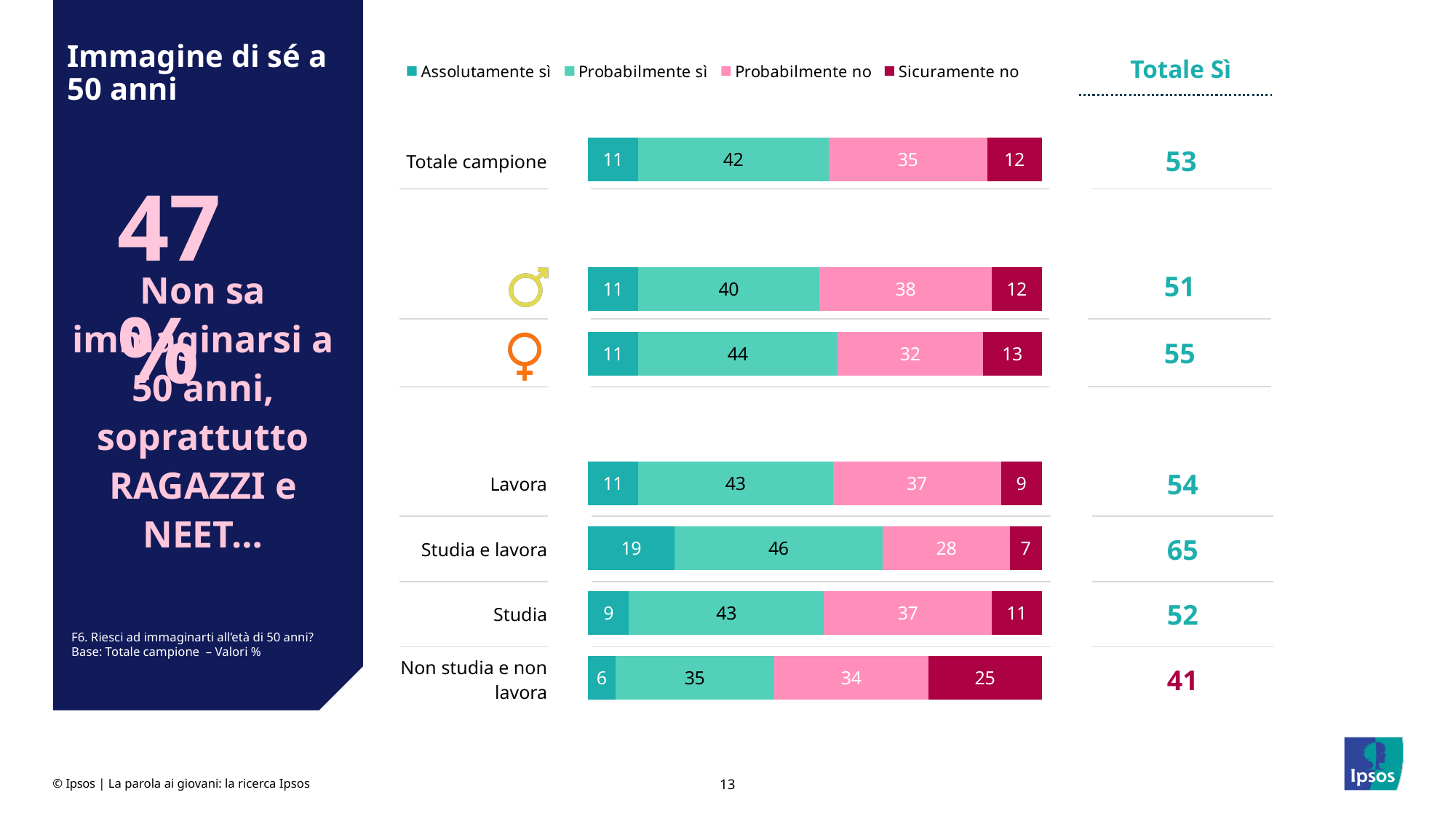
What is the "Totale Sì" value shown for "Studia e lavora"? 65 What kind of chart is shown on the slide? Stacked bar chart Which is larger: the "Probabilmente no" value for "Lavora" or for "Studia e lavora"? Lavora What is the value of "Probabilmente sì" for "Totale campione"? 42 How many series does the legend list? 4 What is the value of "Sicuramente no" for "Non studia e non lavora"? 25 Which category has the highest "Sicuramente no" value? Non studia e non lavora What is the value of "Probabilmente no" for "Studia"? 37 What is the difference between the "Probabilmente sì" values for "Studia e lavora" and "Non studia e non lavora"? 11 How many categories (bars) are shown in the chart? 7 Which category has the lowest "Assolutamente sì" value? Non studia e non lavora What is the value of "Assolutamente sì" for "Studia e lavora"? 19